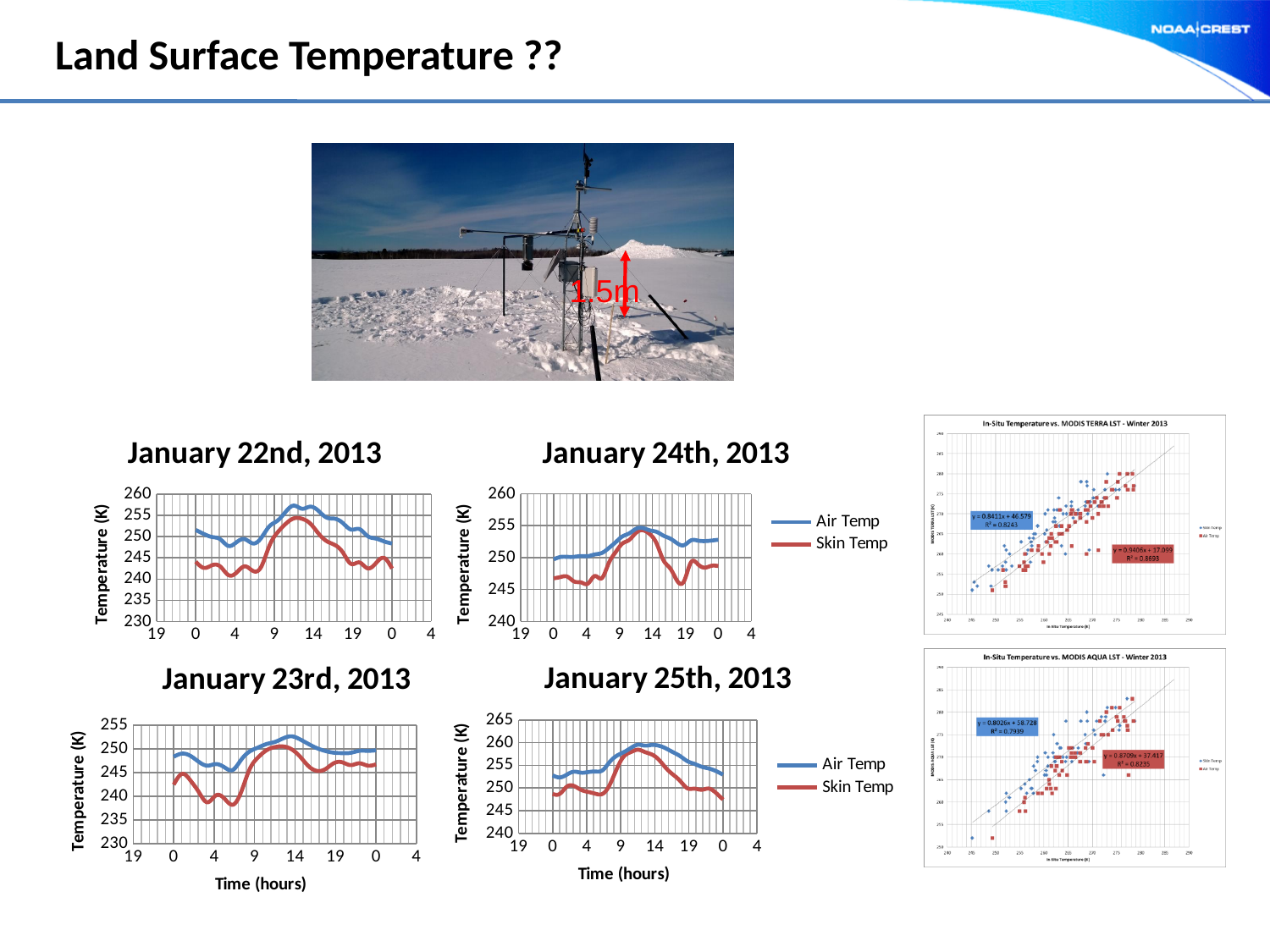
In the 'January 22nd, 2013' chart, which series is higher at hour 4, Air Temp or Skin Temp? Air Temp In the 'January 25th, 2013' chart, is the lowest Skin Temp value greater or less than 255? less How many series does the legend next to the 'January 24th, 2013' chart list? 2 What is the x-axis title shown under the 'January 25th, 2013' chart? Time (hours) In the 'January 23rd, 2013' chart, is the lowest Skin Temp value greater or less than 245? less In the 'January 24th, 2013' chart, is the lowest Skin Temp value greater or less than 250? less In the 'January 24th, 2013' chart, which series is higher at hour 0 at the start of the series, Air Temp or Skin Temp? Air Temp What are the two series named in the legend next to the 'January 25th, 2013' chart? Air Temp and Skin Temp How many line charts titled with a January 2013 date are on the slide? 4 What kind of chart is the 'January 22nd, 2013' chart? line chart